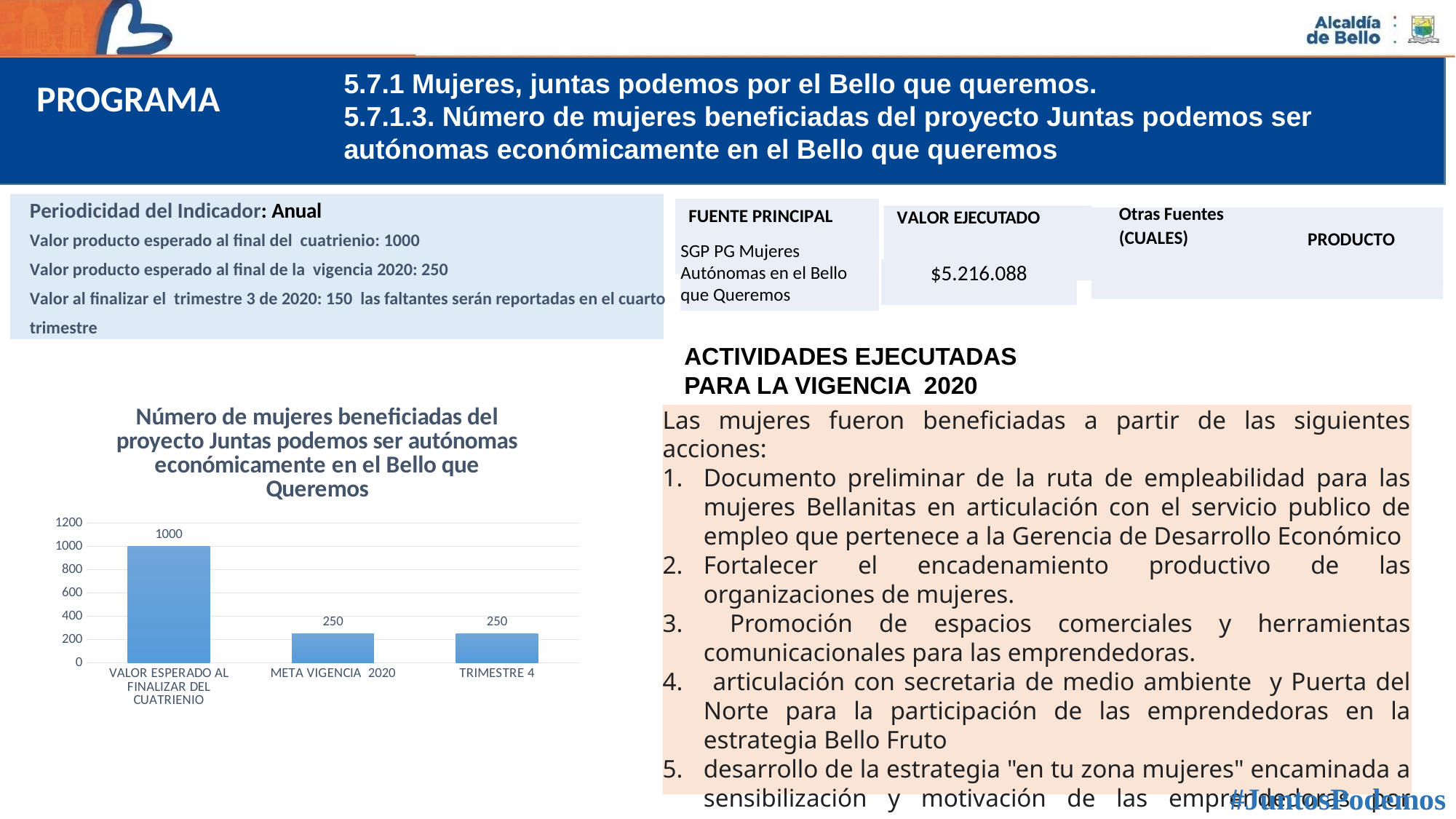
How many categories are shown on the chart? 3 Which category has the highest value? VALOR ESPERADO AL FINALIZAR DEL CUATRIENIO What is the value for VALOR ESPERADO AL FINALIZAR DEL CUATRIENIO? 1000 What is the title of the chart? Número de mujeres beneficiadas del proyecto Juntas podemos ser autónomas económicamente en el Bello que Queremos What is the difference between the value for VALOR ESPERADO AL FINALIZAR DEL CUATRIENIO and the value for META VIGENCIA 2020? 750 Is the value for VALOR ESPERADO AL FINALIZAR DEL CUATRIENIO greater or less than 800? greater Which is larger, the value for VALOR ESPERADO AL FINALIZAR DEL CUATRIENIO or the value for TRIMESTRE 4? VALOR ESPERADO AL FINALIZAR DEL CUATRIENIO What kind of chart is shown on the slide? bar chart What is the highest value shown on the vertical axis of the chart? 1200 What is the value for META VIGENCIA 2020? 250 What is the value for TRIMESTRE 4? 250 Is the value for META VIGENCIA 2020 greater or less than 400? less